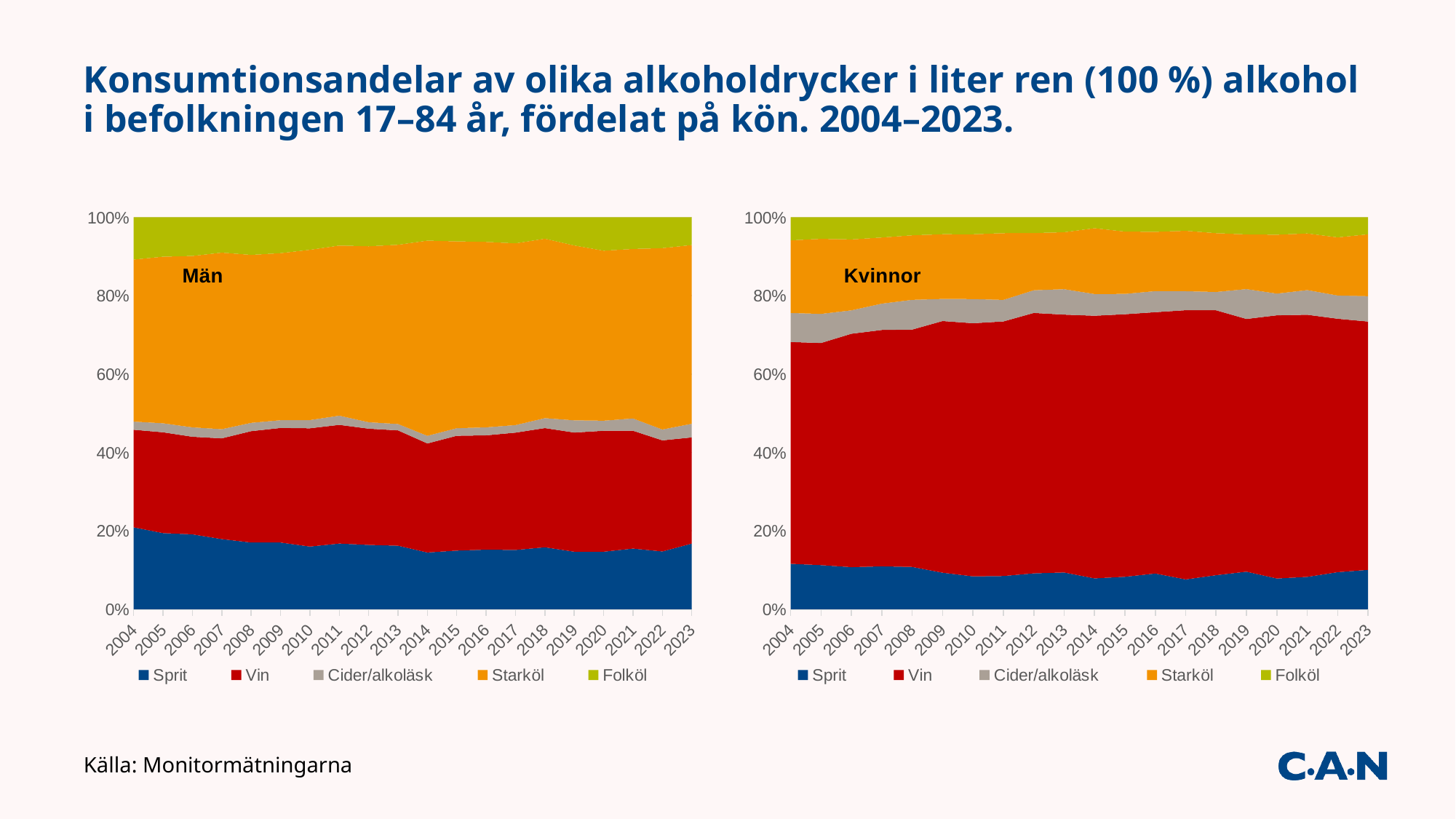
In the Kvinnor chart, is the share for Vin in 2023 greater or less than 60%? greater What kind of chart is used for the Män panel? Stacked area chart In the Män chart, which beverage category takes the largest share in 2023? Starköl Comparing the two charts, is the share of Vin in 2023 larger for Män or for Kvinnor? Kvinnor In the Kvinnor chart, which beverage category takes the largest share in 2023? Vin In the Män chart, which beverage category takes the smallest share in 2023? Cider/alkoläsk How many series does the legend of the Kvinnor chart list? 5 In the Män chart, does the share for Sprit rise or fall from 2004 to 2023? fall How many years are plotted along the x axis of the Män chart? 20 Which colour represents Vin in the legends? Red In the Män chart, is the share for Sprit in 2023 greater or less than 20%? less In the Kvinnor chart, is the share for Starköl in 2023 greater or less than 20%? less